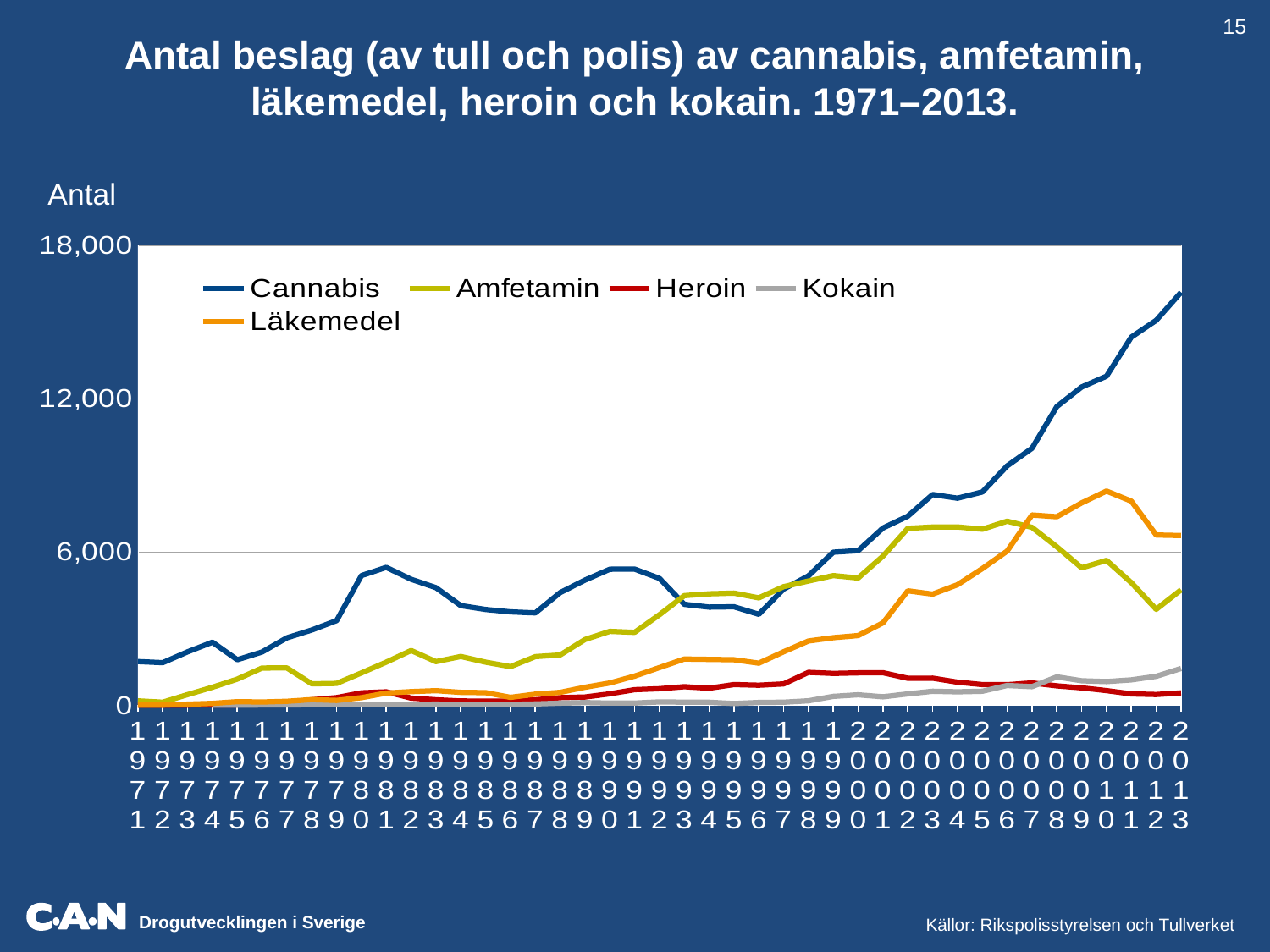
Is the value for Cannabis in 2013 greater or less than 12,000? greater Which series has the lowest value in 2013? Heroin In 2013, which is larger, the value for Cannabis or the value for Amfetamin? Cannabis Which series are listed in the legend? Cannabis, Amfetamin, Heroin, Kokain, Läkemedel Is the value for Amfetamin in 2013 greater or less than 6,000? less What kind of chart is shown on the slide? Line chart How many series does the legend list? 5 Which series has the highest value in 2013? Cannabis What is the label on the vertical axis? Antal Is the value for Cannabis in 1971 greater or less than 6,000? less How many years are plotted along the x axis? 43 Does the Cannabis series overall rise or fall from 1971 to 2013? rise